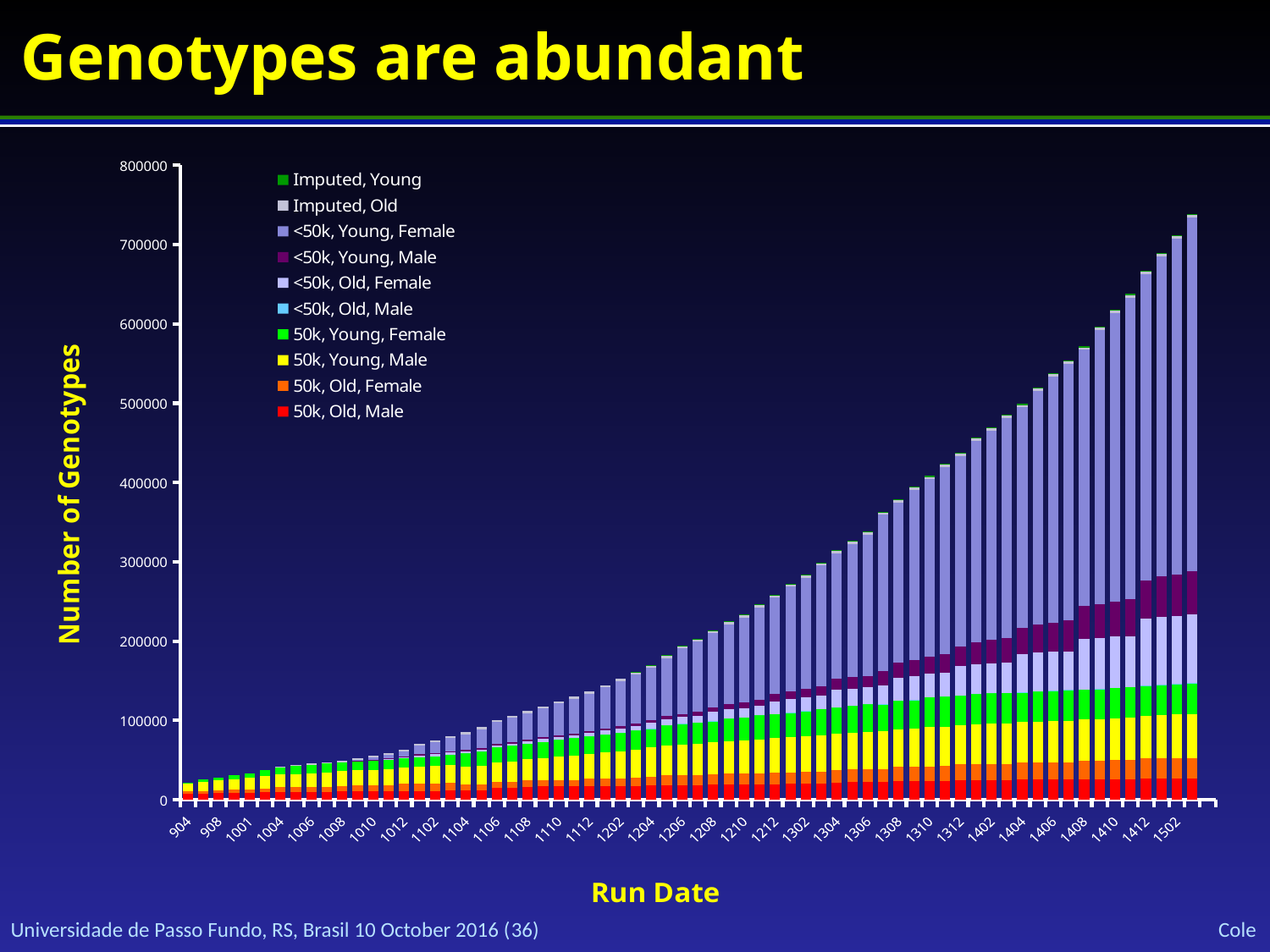
Which run date has a larger total number of genotypes, 1106 or 1306? 1306 What is the label of the y axis? Number of Genotypes What is the title of the slide containing the chart? Genotypes are abundant What kind of chart is shown on the slide? stacked bar chart Which run date has the lowest total number of genotypes? 904 Is the total number of genotypes for run date 1306 greater or less than 300000? greater Is the total number of genotypes for run date 1408 greater or less than 500000? greater Is the total number of genotypes for run date 904 greater or less than 100000? less How many series does the legend list? 10 Do the total number of genotypes rise or fall as the run date moves from 904 to 1502? rise